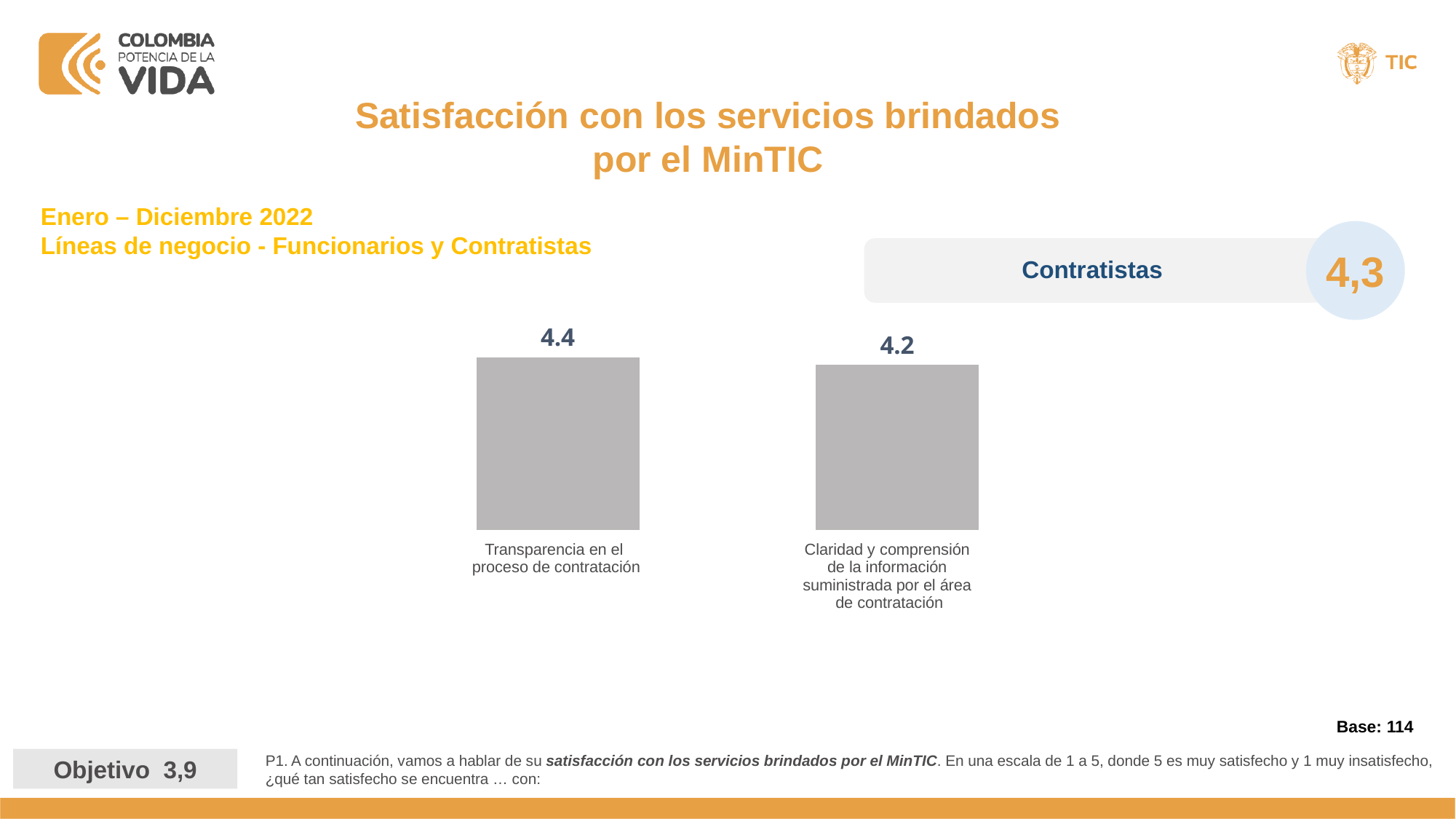
Do the values rise or fall from left to right across the chart? Fall Which category has the lowest value? Claridad y comprensión de la información suministrada por el área de contratación What is the base (number of respondents) shown on the slide? 114 Which is larger: the value for "Transparencia en el proceso de contratación" or for "Claridad y comprensión de la información suministrada por el área de contratación"? Transparencia en el proceso de contratación What overall score is shown for "Contratistas" on the slide? 4,3 What is the difference between the values for "Transparencia en el proceso de contratación" and "Claridad y comprensión de la información suministrada por el área de contratación"? 0.2 How many categories are shown in the chart? 2 What is the value for "Transparencia en el proceso de contratación"? 4.4 What kind of chart is shown on the slide? Bar chart Which category has the highest value? Transparencia en el proceso de contratación What is the value for "Claridad y comprensión de la información suministrada por el área de contratación"? 4.2